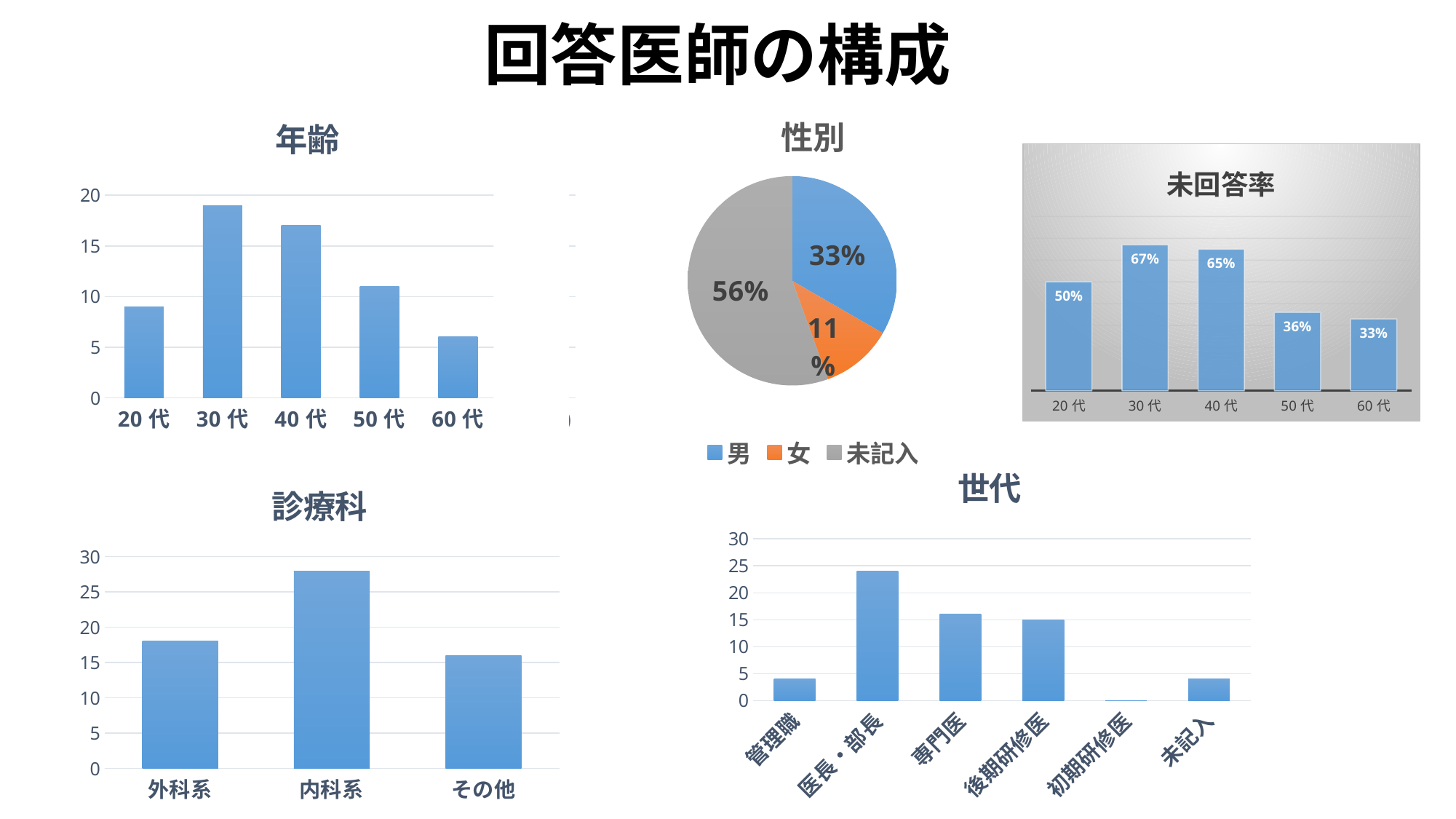
In the 世代 chart, is the value for 医長・部長 greater or less than 20? greater In the 未回答率 chart, what is the difference between the values for 20代 and 50代? 14% How many categories are shown on the x axis of the 世代 chart? 6 In the 性別 pie chart, what share does 未記入 have? 56% How many entries does the legend of the 性別 pie chart list? 3 In the 年齢 chart, which age group has the highest bar? 30代 In the 性別 pie chart, what is the value for 女? 11% In the 未回答率 chart, what is the value for 30代? 67% In the 年齢 chart, is the value for 50代 greater or less than 10? greater In the 未回答率 chart, what is the value for 60代? 33% In the 未回答率 chart, which age group has the highest value? 30代 In the 診療科 chart, which category has the highest bar? 内科系